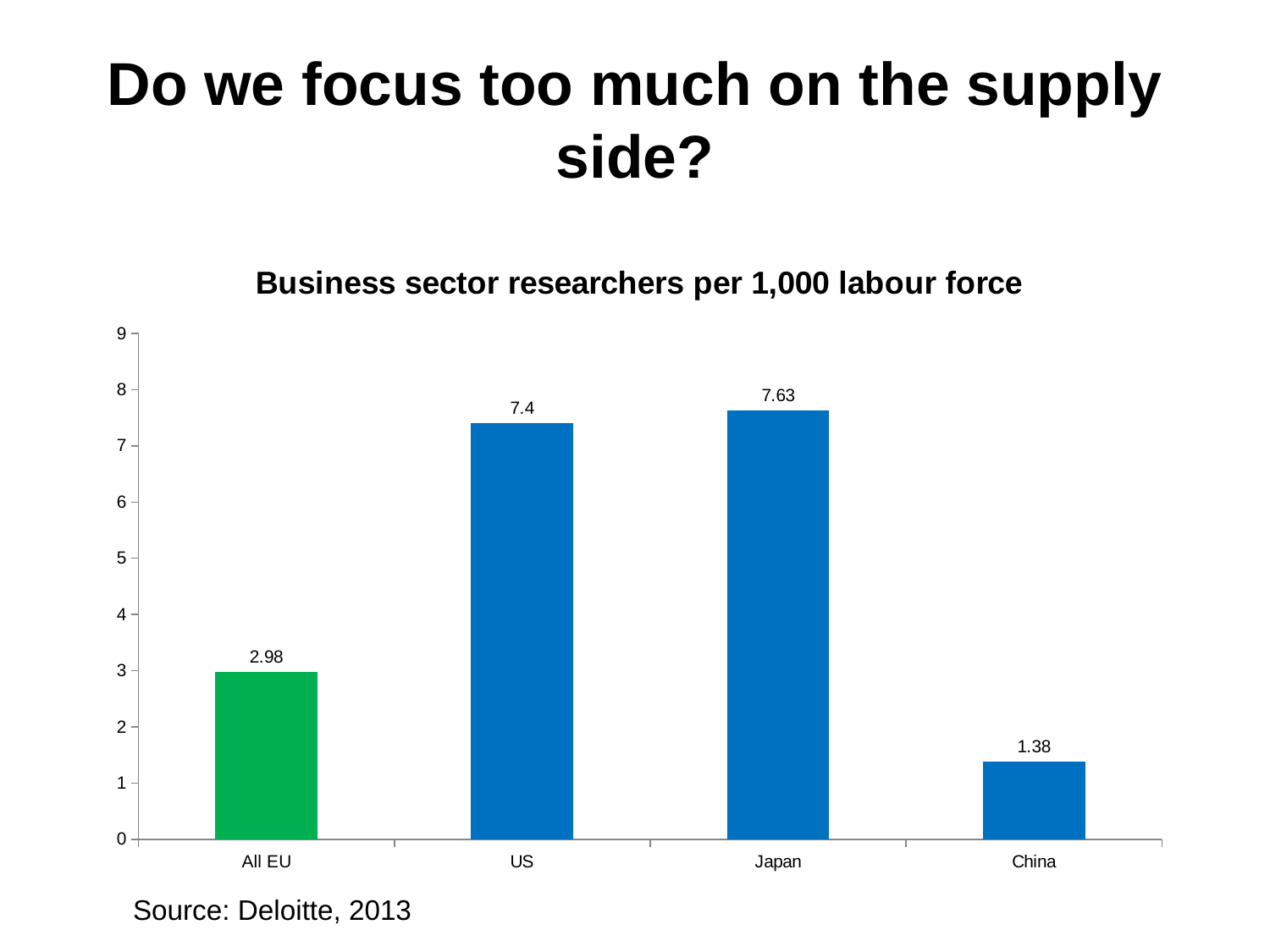
What is the difference between the values for Japan and the US? 0.23 What kind of chart is this? Bar chart Which category has the highest value? Japan What is the value for All EU? 2.98 How many categories are shown on the chart? 4 Which category has the lowest value? China What is the title of the chart? Business sector researchers per 1,000 labour force What is the value for Japan? 7.63 Which is larger, the value for All EU or the value for the US? US What is the difference between the values for All EU and China? 1.6 What is the value for the US? 7.4 What is the value for China? 1.38